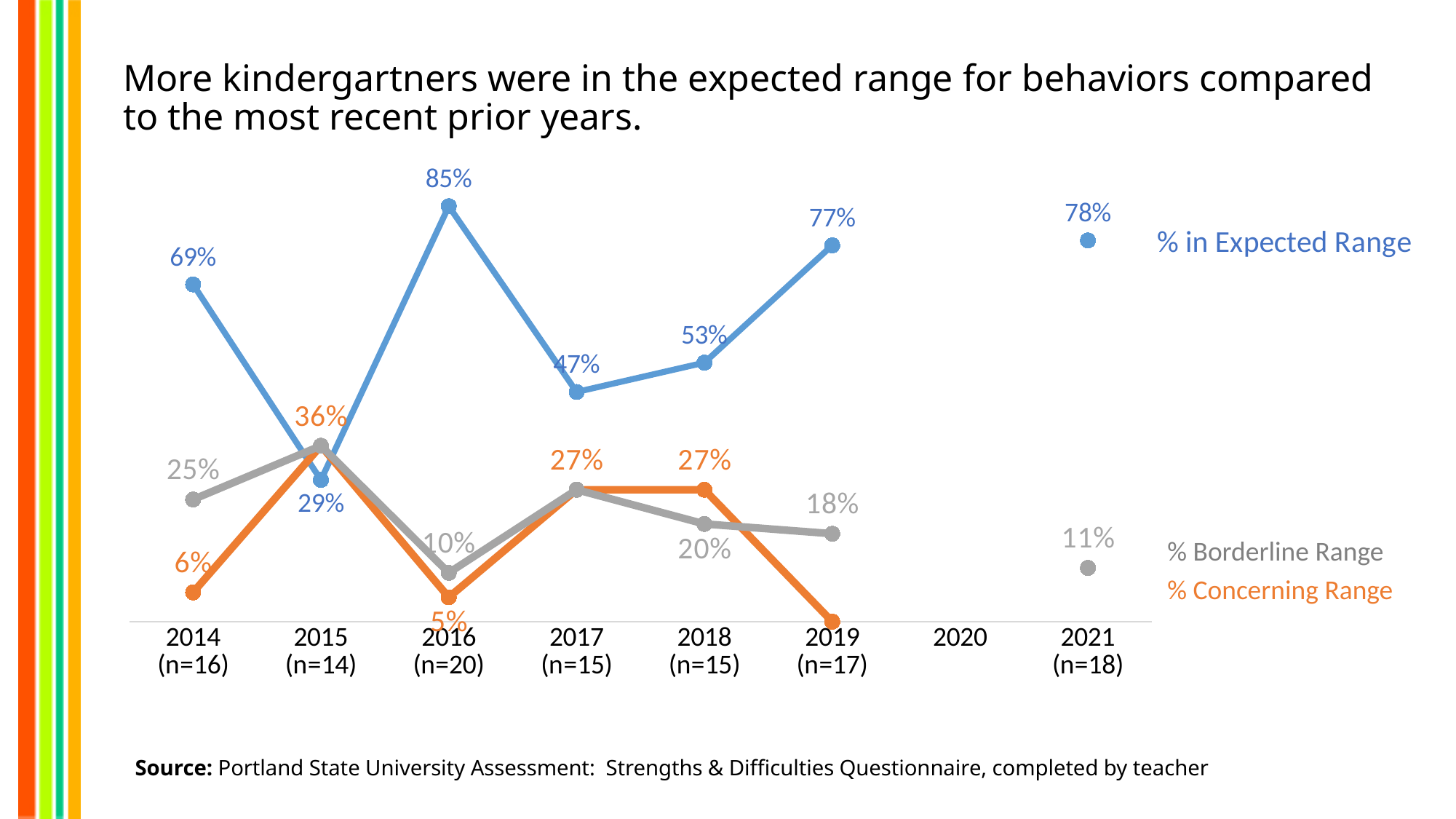
What is the % Borderline Range value for 2021 (n=18)? 11% How many series does the legend list? 3 What is the % Concerning Range value for 2014 (n=16)? 6% In which year was the % in Expected Range highest? 2016 What is the % Borderline Range value for 2014 (n=16)? 25% By how many percentage points did the % in Expected Range change from 2015 to 2016? 56 percentage points Does the % in Expected Range rise or fall from 2017 to 2019? Rise In which year was the % in Expected Range lowest? 2015 What kind of chart is shown on the slide? Line chart What is the % in Expected Range value for 2016 (n=20)? 85% Which year had a higher % in Expected Range, 2017 or 2018? 2018 What is the % Concerning Range value for 2016 (n=20)? 5%